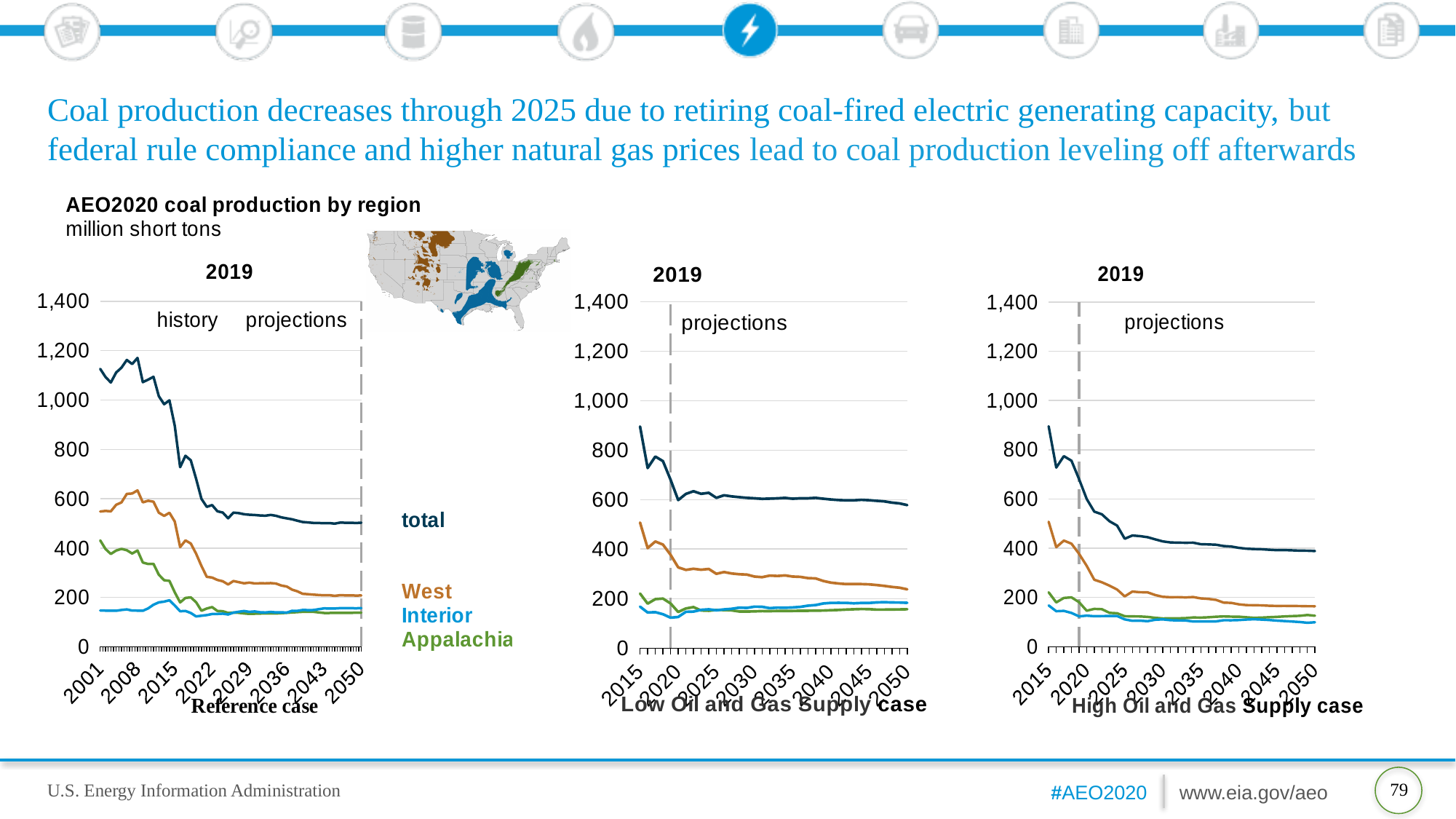
In the Low Oil and Gas Supply case chart, is the total value in 2050 greater or less than 400? greater In the Reference case chart, which region (West, Interior or Appalachia) has the highest production in 2050? West In the Reference case chart, is the West value in 2008 greater or less than 400? greater How many series are plotted in the Reference case chart? 4 In the High Oil and Gas Supply case chart, is the total value in 2050 greater or less than 600? less What unit of measurement is shown for the charts? million short tons In the High Oil and Gas Supply case chart, does the West series rise or fall from 2015 to 2050? fall Is the total coal production in 2050 larger in the Low Oil and Gas Supply case chart or the High Oil and Gas Supply case chart? Low Oil and Gas Supply case In the Reference case chart, does the total coal production rise or fall from 2001 to 2050? fall What kind of chart is the Reference case chart? line chart Which year is marked by the dashed vertical line separating history from projections in the charts? 2019